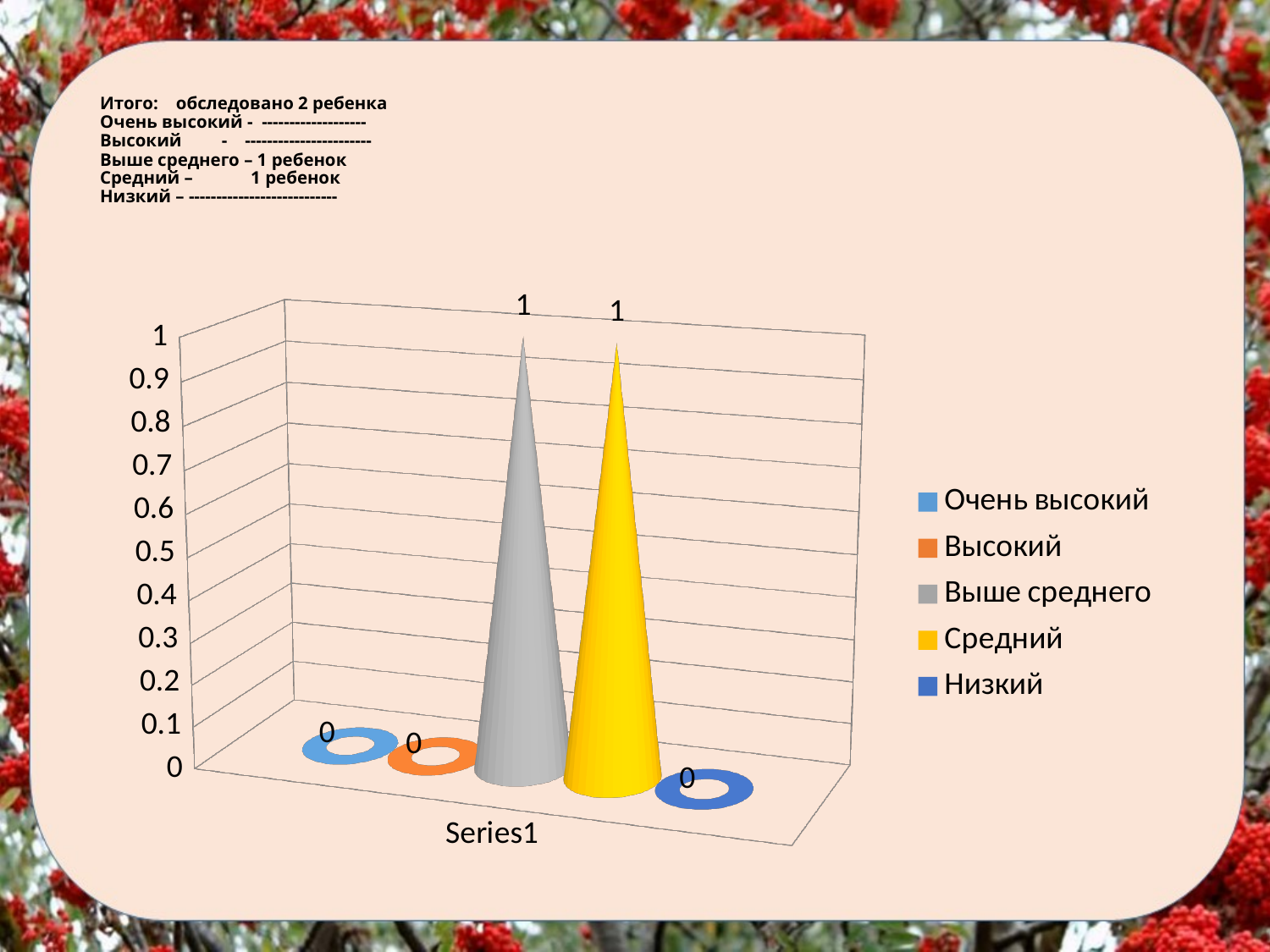
What is the total of all five values shown in the chart? 2 What is the value for Выше среднего? 1 Which is larger, the value for Средний or the value for Низкий? Средний What is the value for Средний? 1 What kind of chart is shown on the slide? bar chart What is the value for Высокий? 0 What is the difference between the value for Выше среднего and the value for Высокий? 1 How many series does the legend list? 5 What is the value for Низкий? 0 What is the label on the x axis of the chart? Series1 What colour is the bar for Средний? yellow What is the value for Очень высокий? 0